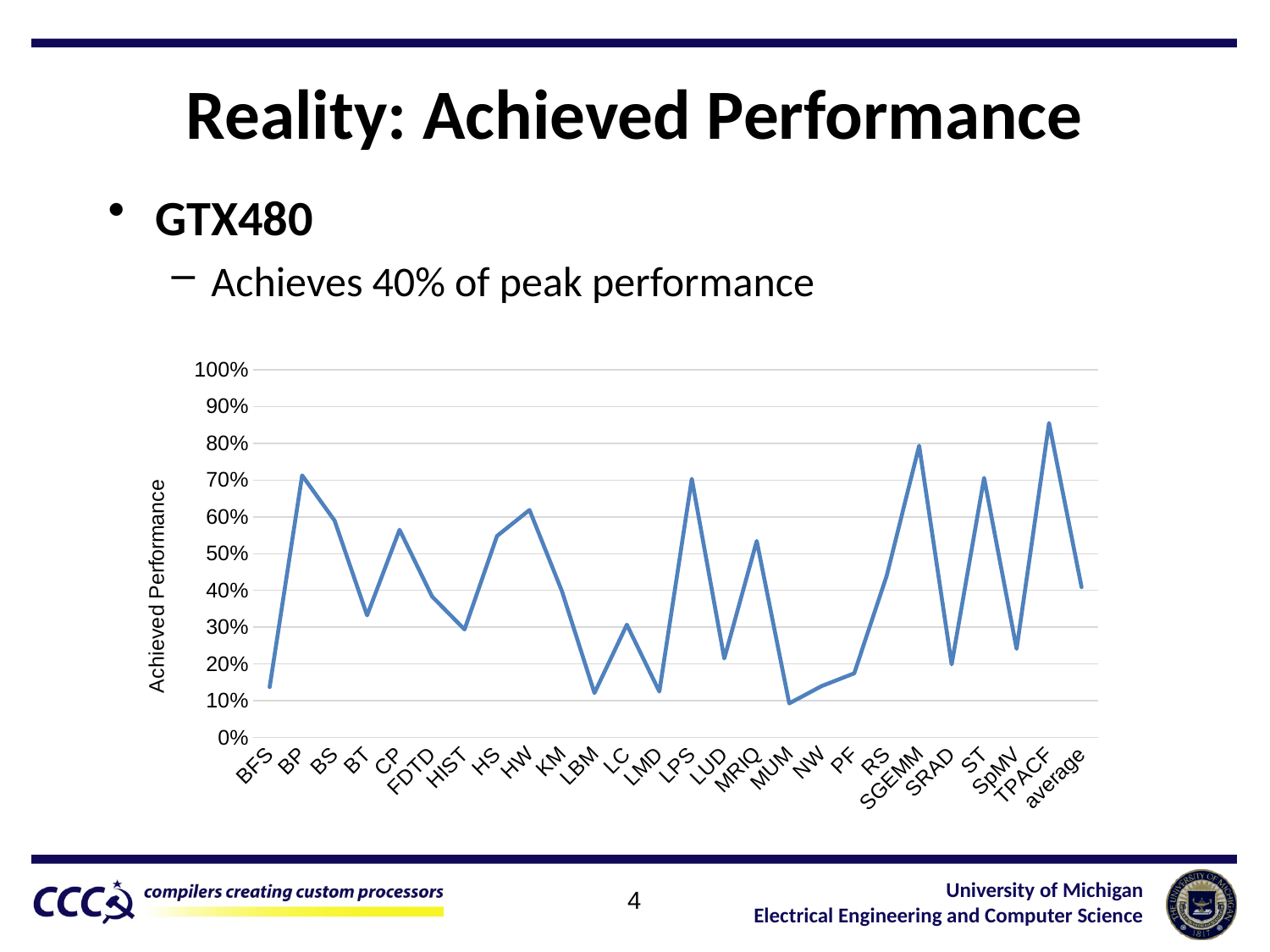
What is the label on the y axis of the chart? Achieved Performance Is the value for LPS greater or less than 60%? greater Is the value for SGEMM greater or less than 70%? greater Which has a lower achieved performance, LBM or LC? LBM Is the value for BFS greater or less than 20%? less Which has a higher achieved performance, TPACF or SGEMM? TPACF Which category has the highest achieved performance in the chart? TPACF Which has a higher achieved performance, BP or BT? BP What kind of chart is shown on the slide? line chart How many categories are plotted along the x axis of the chart? 26